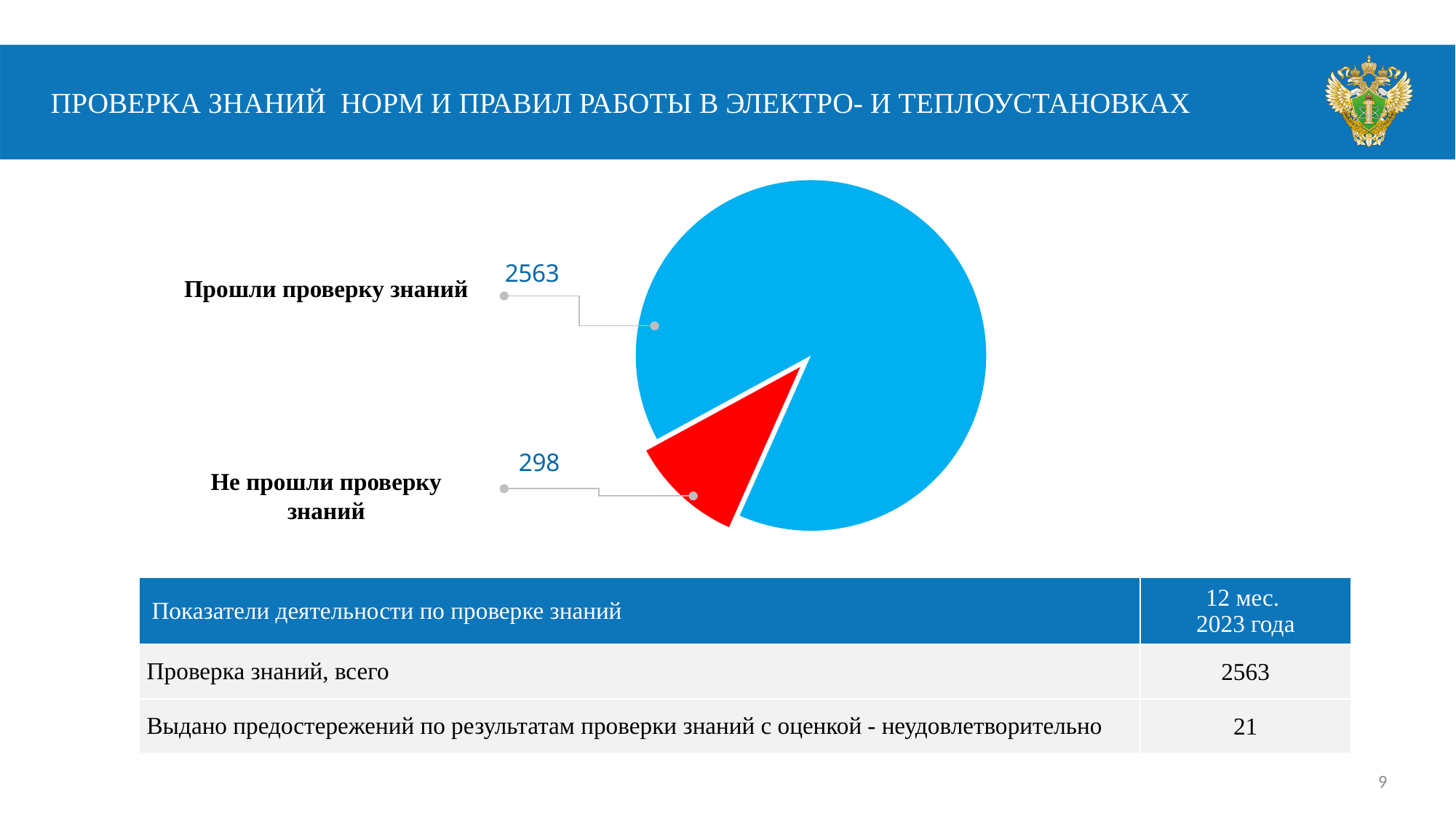
What colour is the slice for "Не прошли проверку знаний"? Red Which is larger: the value for "Прошли проверку знаний" or for "Не прошли проверку знаний"? Прошли проверку знаний What kind of chart is shown on the slide? Pie chart Which category has the largest slice in the pie chart? Прошли проверку знаний Which category has the smallest slice in the pie chart? Не прошли проверку знаний What is the difference between the values for "Прошли проверку знаний" and "Не прошли проверку знаний"? 2265 How many categories are shown in the pie chart? 2 What is the total of the two values shown in the pie chart? 2861 What is the value for "Прошли проверку знаний" in the pie chart? 2563 What is the value for "Не прошли проверку знаний" in the pie chart? 298 What colour is the slice for "Прошли проверку знаний"? Blue